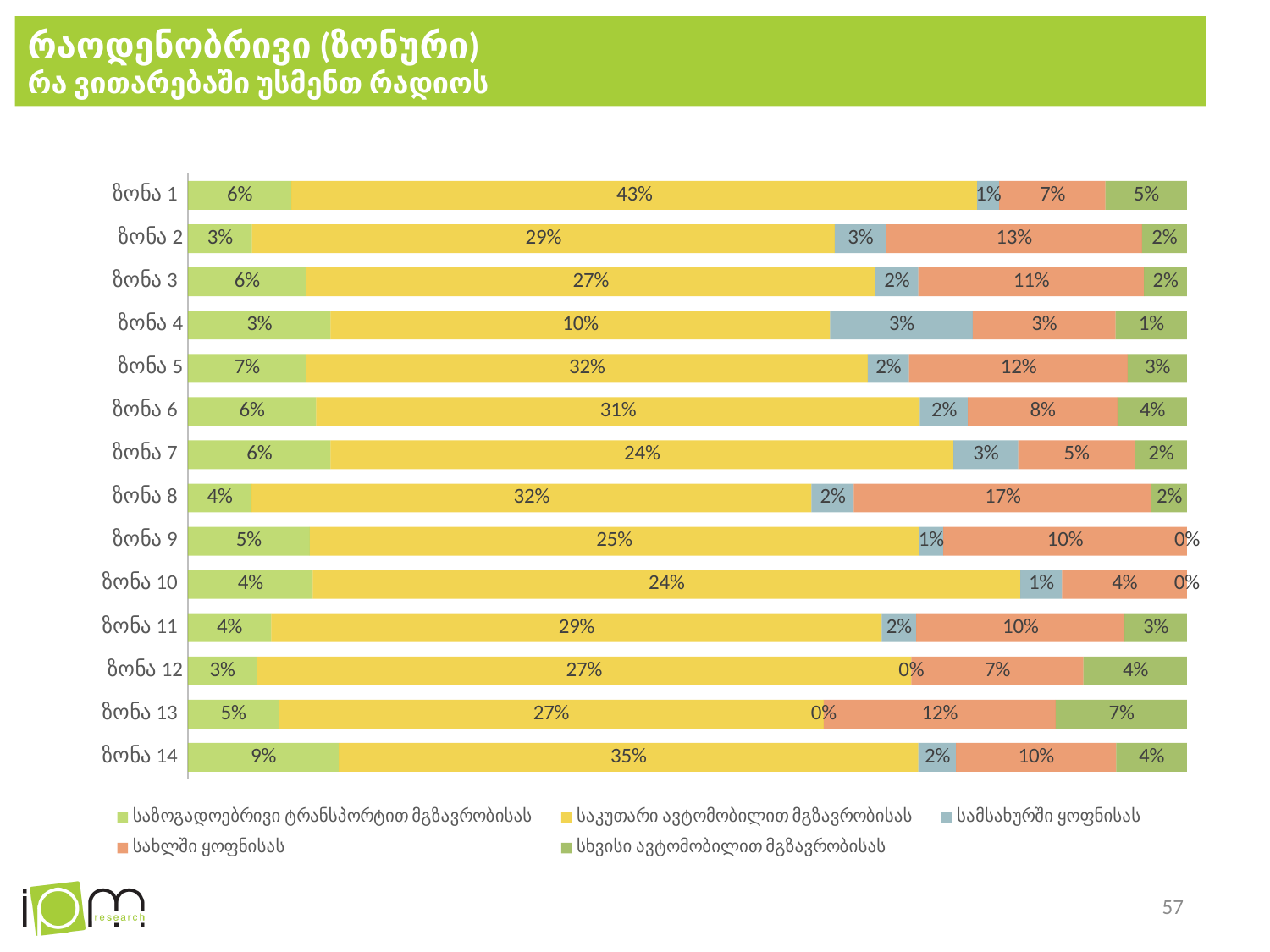
Which zone has the highest value for სახლში ყოფნისას? ზონა 8 What is the value for სახლში ყოფნისას in ზონა 8? 17% What is the value for სხვისი ავტომობილით მგზავრობისას in ზონა 13? 7% What is the value for საკუთარი ავტომობილით მგზავრობისას in ზონა 1? 43% Which is larger: the სახლში ყოფნისას value for ზონა 5 or for ზონა 6? ზონა 5 Which zone has the highest value for საკუთარი ავტომობილით მგზავრობისას? ზონა 1 Which zone has the lowest value for საკუთარი ავტომობილით მგზავრობისას? ზონა 4 How many zones are shown on the chart? 14 How many series does the legend list? 5 What kind of chart is shown on the slide? Stacked bar chart What is the value for საზოგადოებრივი ტრანსპორტით მგზავრობისას in ზონა 14? 9% What is the difference between the საკუთარი ავტომობილით მგზავრობისას values for ზონა 1 and ზონა 2? 14 percentage points